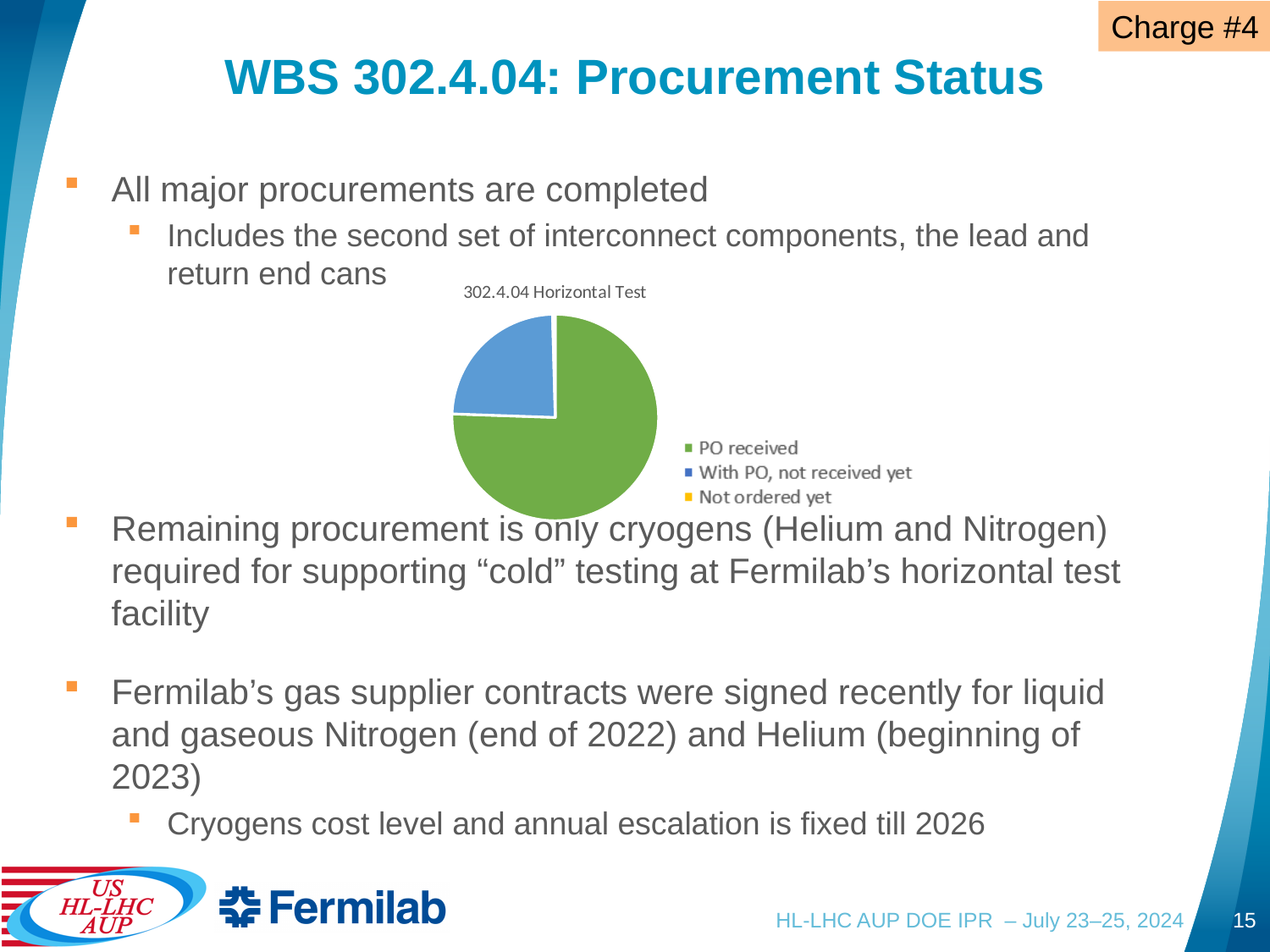
How many entries does the legend of the pie chart list? 3 Which legend category of the pie chart has no visible slice? Not ordered yet Which category has the largest slice in the pie chart? PO received What kind of chart is shown on the slide? Pie chart What colour represents PO received in the pie chart? Green How many slices are visible in the pie chart? 2 What is the title of the pie chart? 302.4.04 Horizontal Test Which is larger in the pie chart: the slice for PO received or the slice for With PO, not received yet? PO received